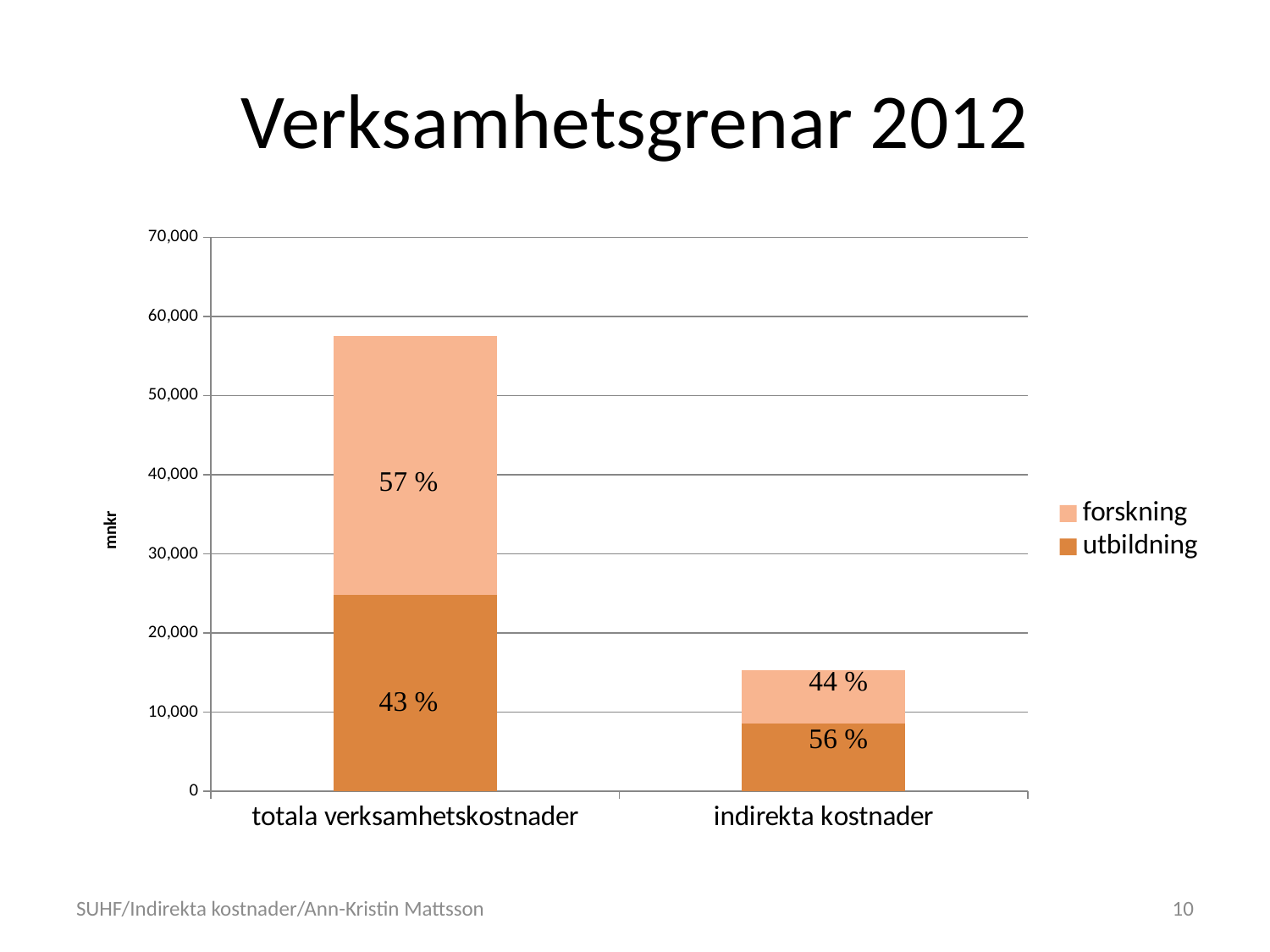
Is the total height of the totala verksamhetskostnader bar greater or less than 50,000? greater What percentage label is shown on the utbildning segment of the indirekta kostnader bar? 56 % Which category has the taller stacked bar, totala verksamhetskostnader or indirekta kostnader? totala verksamhetskostnader How many series does the legend list? 2 What percentage label is shown on the utbildning segment of the totala verksamhetskostnader bar? 43 % Is the total height of the indirekta kostnader bar greater or less than 20,000? less What is the title of the chart on the slide? Verksamhetsgrenar 2012 What percentage label is shown on the forskning segment of the totala verksamhetskostnader bar? 57 % What type of chart is shown on the slide? stacked bar chart What percentage label is shown on the forskning segment of the indirekta kostnader bar? 44 % How many categories are shown on the x axis? 2 What unit is shown on the vertical axis label? mnkr